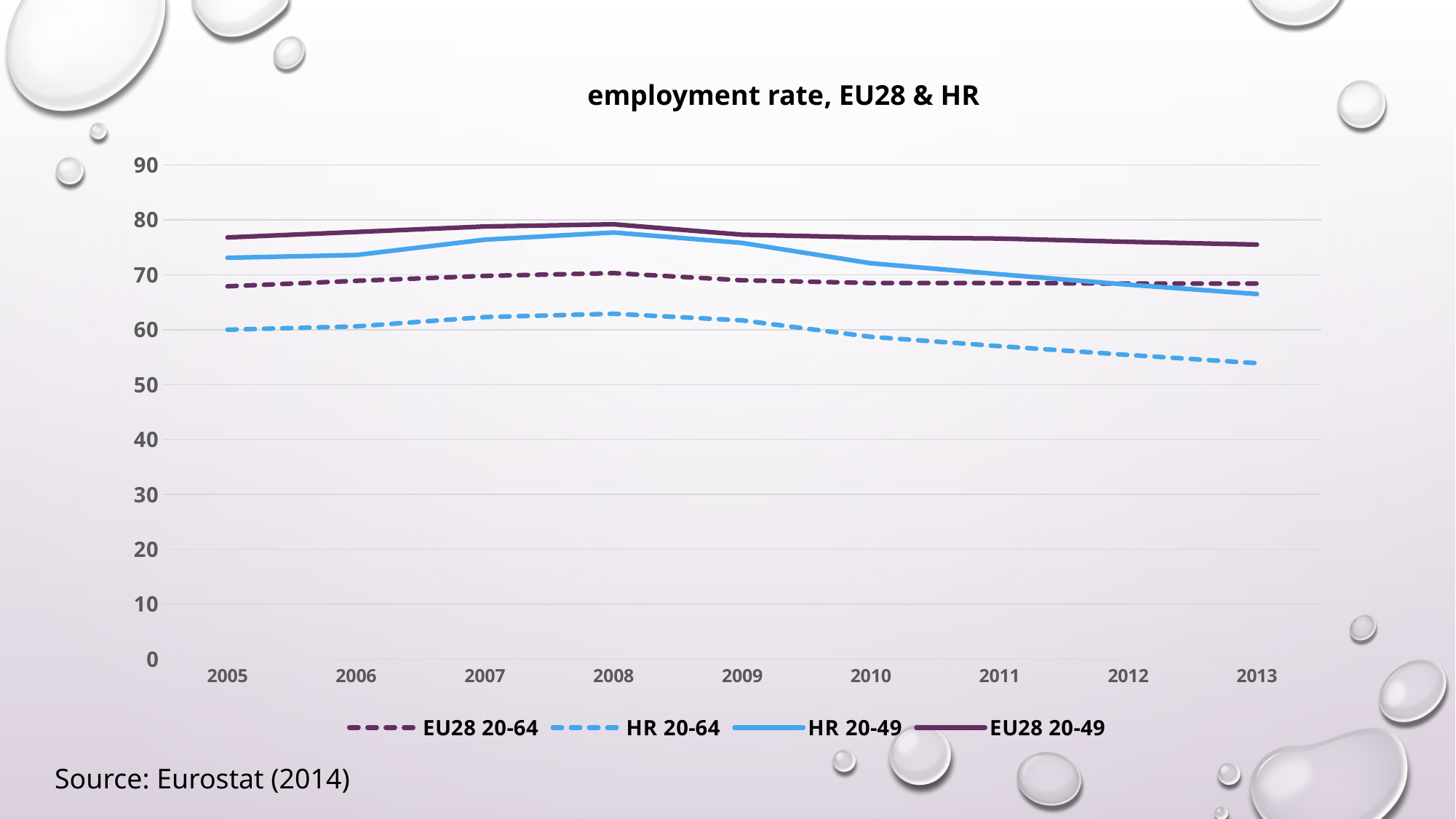
What kind of chart is shown on the slide? line chart How many years are shown on the x axis? 9 How many series does the legend list? 4 Which series has the highest value in 2005? EU28 20-49 Is the value for HR 20-64 in 2013 greater or less than 60? less Is the value for EU28 20-49 in 2008 greater or less than 70? greater What is the title of the chart? employment rate, EU28 & HR In 2005, which is larger: HR 20-49 or EU28 20-64? HR 20-49 In which year does the HR 20-64 series reach its highest value? 2008 Is the value for HR 20-49 in 2013 greater or less than 60? greater Which series has the lowest value in 2013? HR 20-64 Does the HR 20-64 series rise or fall from 2008 to 2013? fall